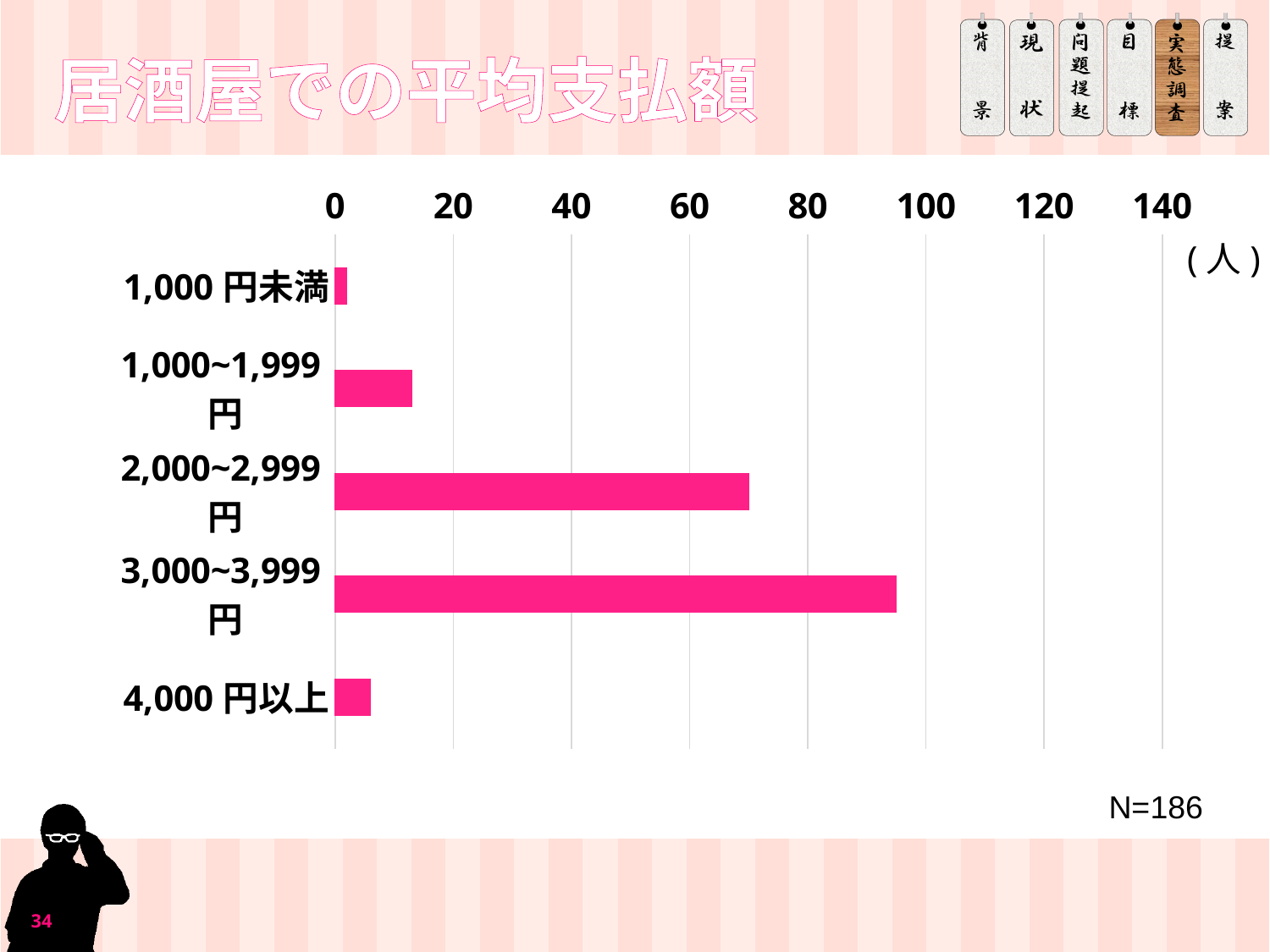
What kind of chart is shown on the slide? bar chart What sample size (N) is shown below the chart? N=186 Is the value for 3,000~3,999円 greater or less than 100? less Is the value for 3,000~3,999円 greater or less than 80? greater Which category has the highest value? 3,000~3,999円 Which is larger, the value for 2,000~2,999円 or the value for 1,000~1,999円? 2,000~2,999円 How many categories are plotted in the chart? 5 Is the value for 2,000~2,999円 greater or less than 60? greater Which category has the lowest value? 1,000円未満 What is the title of the chart? 居酒屋での平均支払額